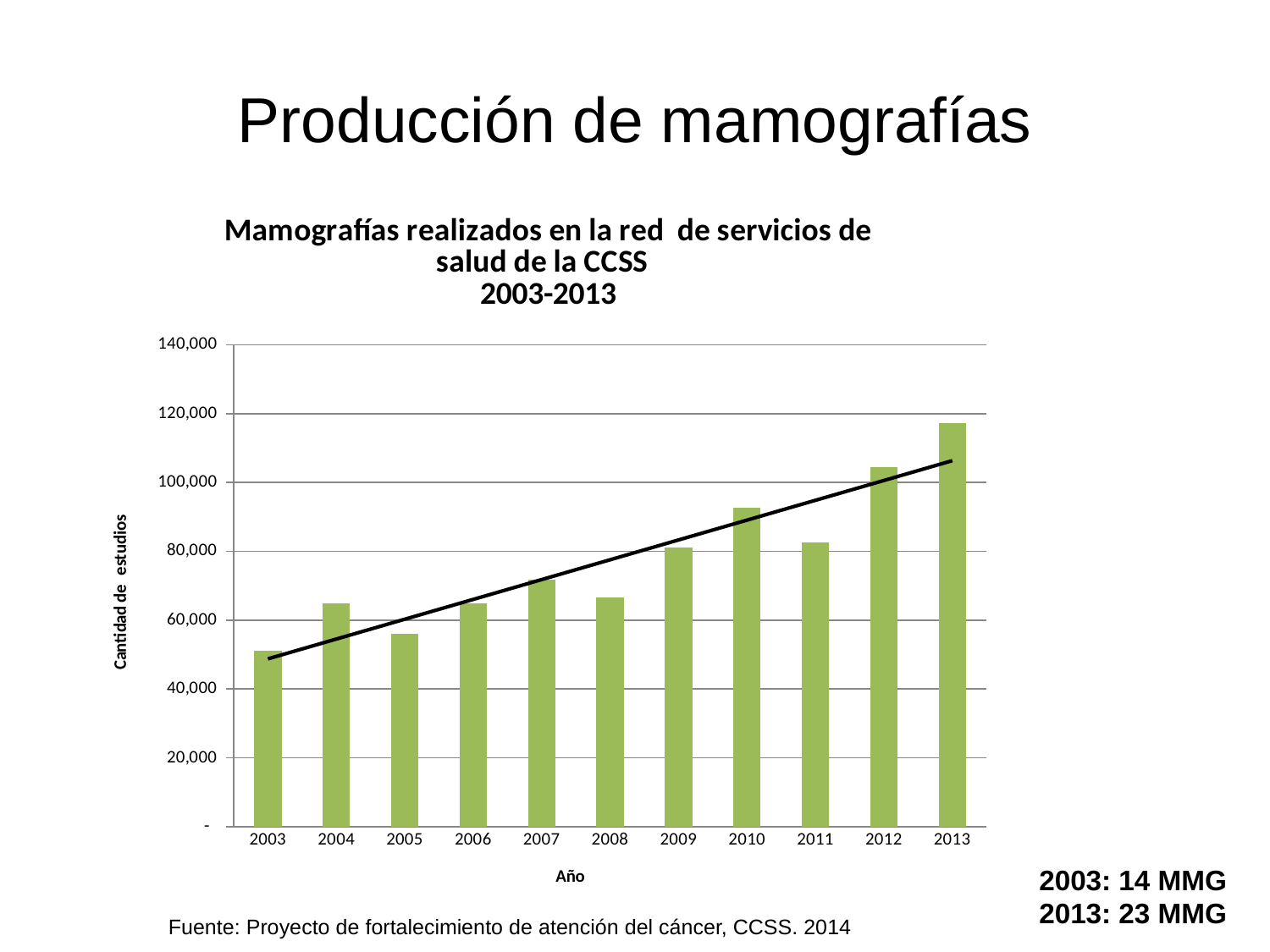
Do the values generally rise or fall from 2003 to 2013? Rise Is the value for 2013 greater or less than 100,000? greater How many years are plotted on the x axis of the chart? 11 Which year has the highest number of mammograms in the chart? 2013 Is the value for 2003 greater or less than 60,000? less Is the value for 2007 greater or less than 80,000? less Which year has the larger value, 2010 or 2011? 2010 What is the label of the vertical axis of the chart? Cantidad de estudios What kind of chart is shown on the slide? Bar chart Which year has the larger value, 2004 or 2005? 2004 Which year has the lowest number of mammograms in the chart? 2003